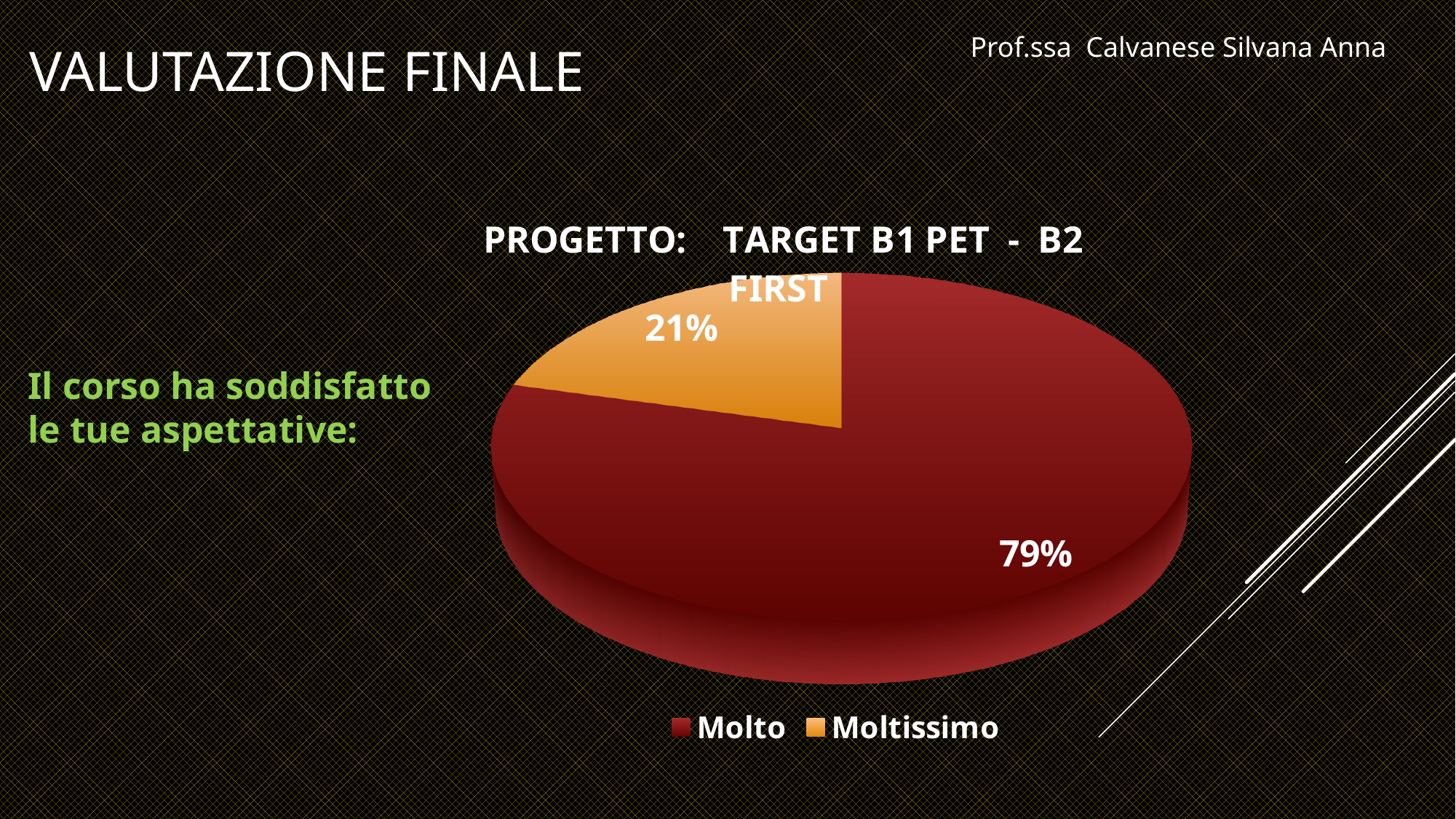
What percentage of the pie does the Moltissimo slice represent? 21% Which category has the smallest slice of the pie? Moltissimo What percentage of the pie does the Molto slice represent? 79% Which slice is larger, Molto or Moltissimo? Molto How many slices does the pie chart have? 2 How many entries does the legend list? 2 What colour is the Moltissimo slice? Orange Which category has the largest slice of the pie? Molto What is the difference in percentage points between the Molto and Moltissimo slices? 58 What is the title of the chart? PROGETTO: TARGET B1 PET - B2 FIRST What kind of chart is shown on the slide? Pie chart